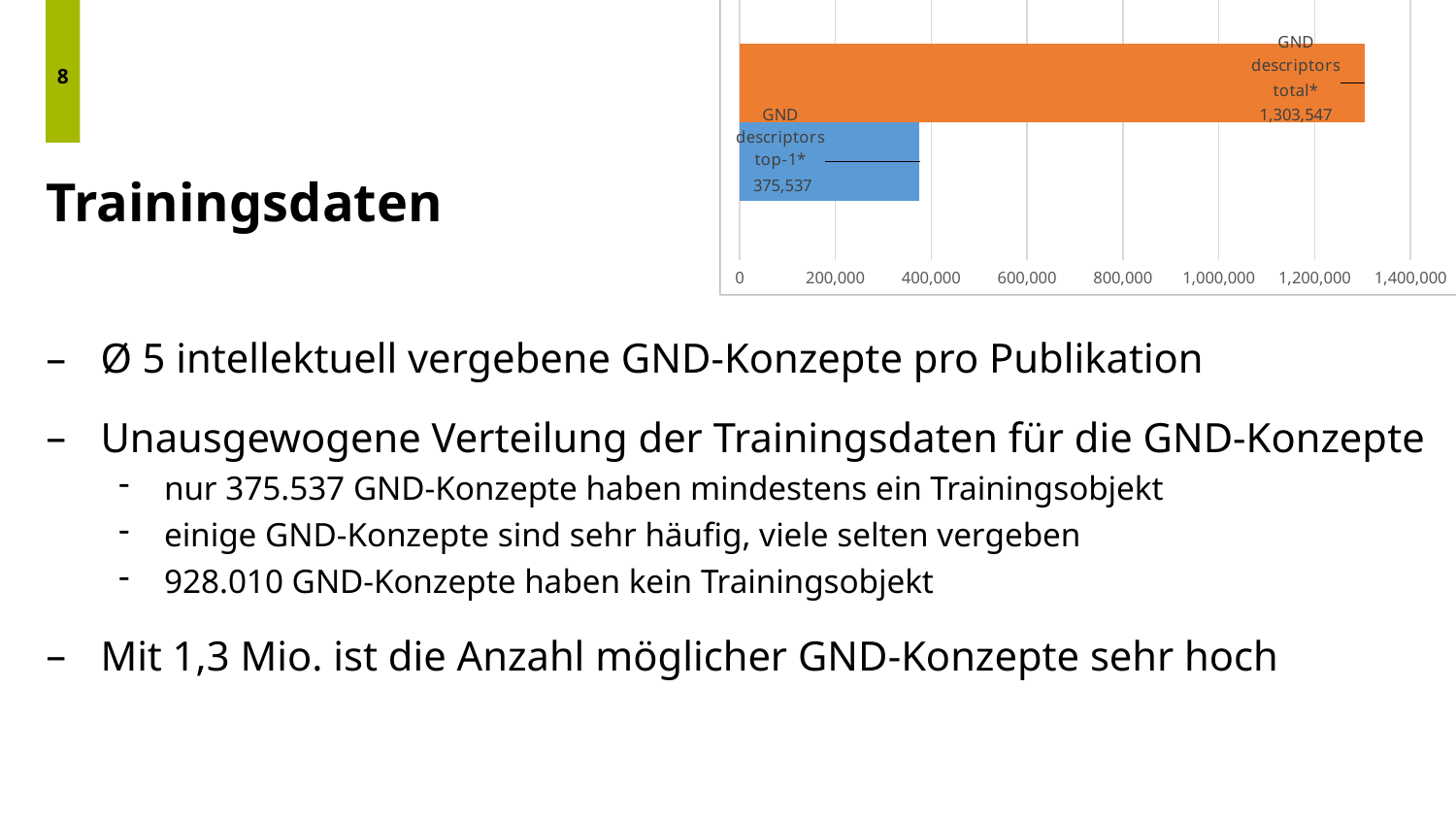
What value is shown for GND descriptors top-1*? 375,537 Is the value for GND descriptors total* greater or less than 1,200,000? greater Which bar has the higher value, GND descriptors top-1* or GND descriptors total*? GND descriptors total* Is the value for GND descriptors top-1* larger or smaller than the value for GND descriptors total*? smaller Is the value for GND descriptors top-1* greater or less than 400,000? less What is the difference between the GND descriptors total* value and the GND descriptors top-1* value? 928,010 What is the highest tick value shown on the horizontal axis of the chart? 1,400,000 What colour is the bar for GND descriptors total*? orange What value is shown for GND descriptors total*? 1,303,547 What type of chart is shown on the slide? bar chart Which bar has the lowest value in the chart? GND descriptors top-1* How many bars are plotted in the chart? 2